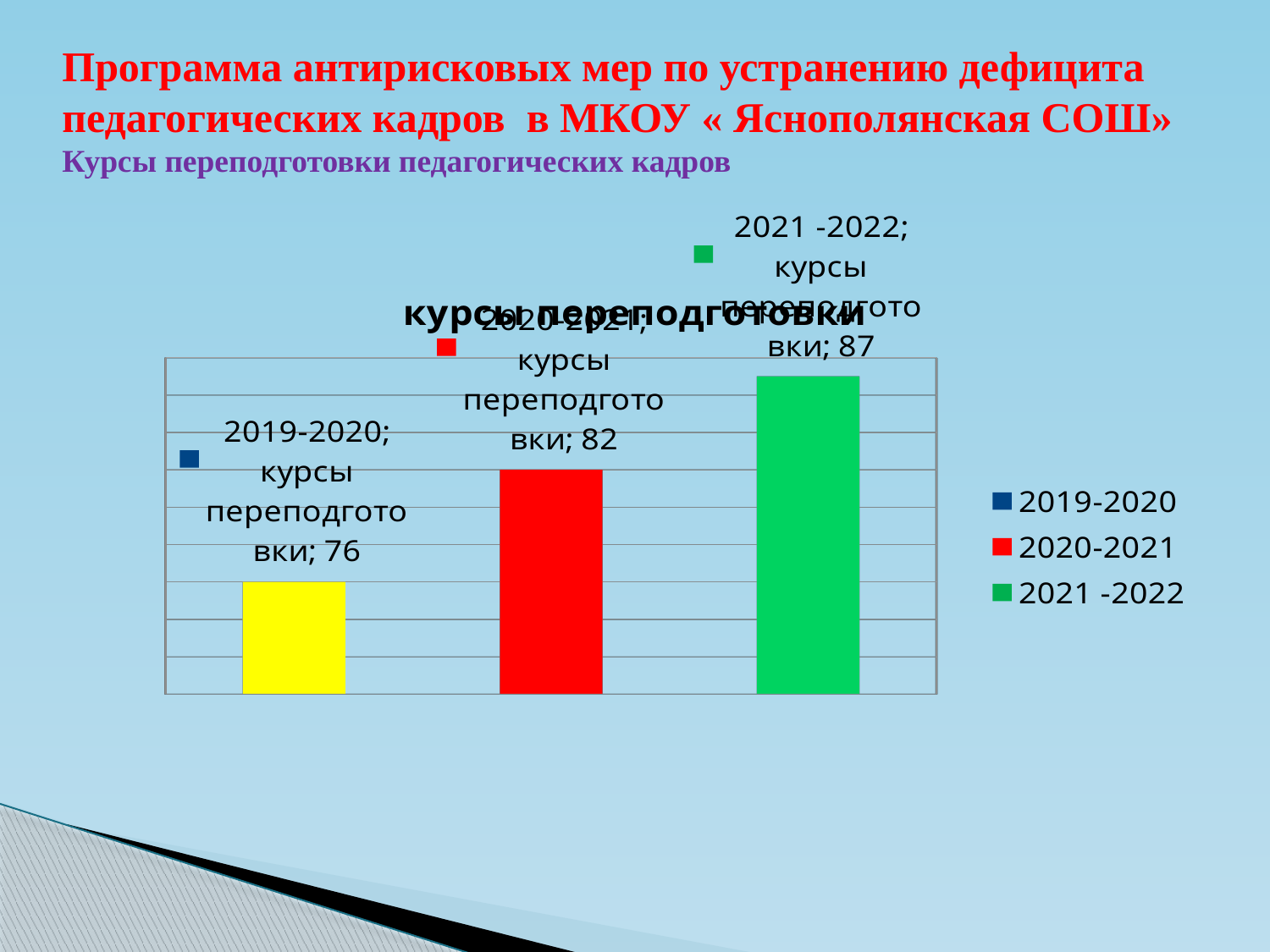
How many bars are plotted in the chart? 3 Which is larger, the value for 2020-2021 or the value for 2021-2022? 2021-2022 Do the values rise or fall from 2019-2020 to 2021-2022? rise What kind of chart is shown on the slide? bar chart What is the value for 2019-2020 in the chart? 76 What is the value for 2021-2022 in the chart? 87 Which period has the lowest value in the chart? 2019-2020 How many entries does the chart legend list? 3 Which period has the highest value in the chart? 2021-2022 What is the value for 2020-2021 in the chart? 82 What is the difference between the values for 2021-2022 and 2019-2020? 11 What is the difference between the values for 2020-2021 and 2019-2020? 6